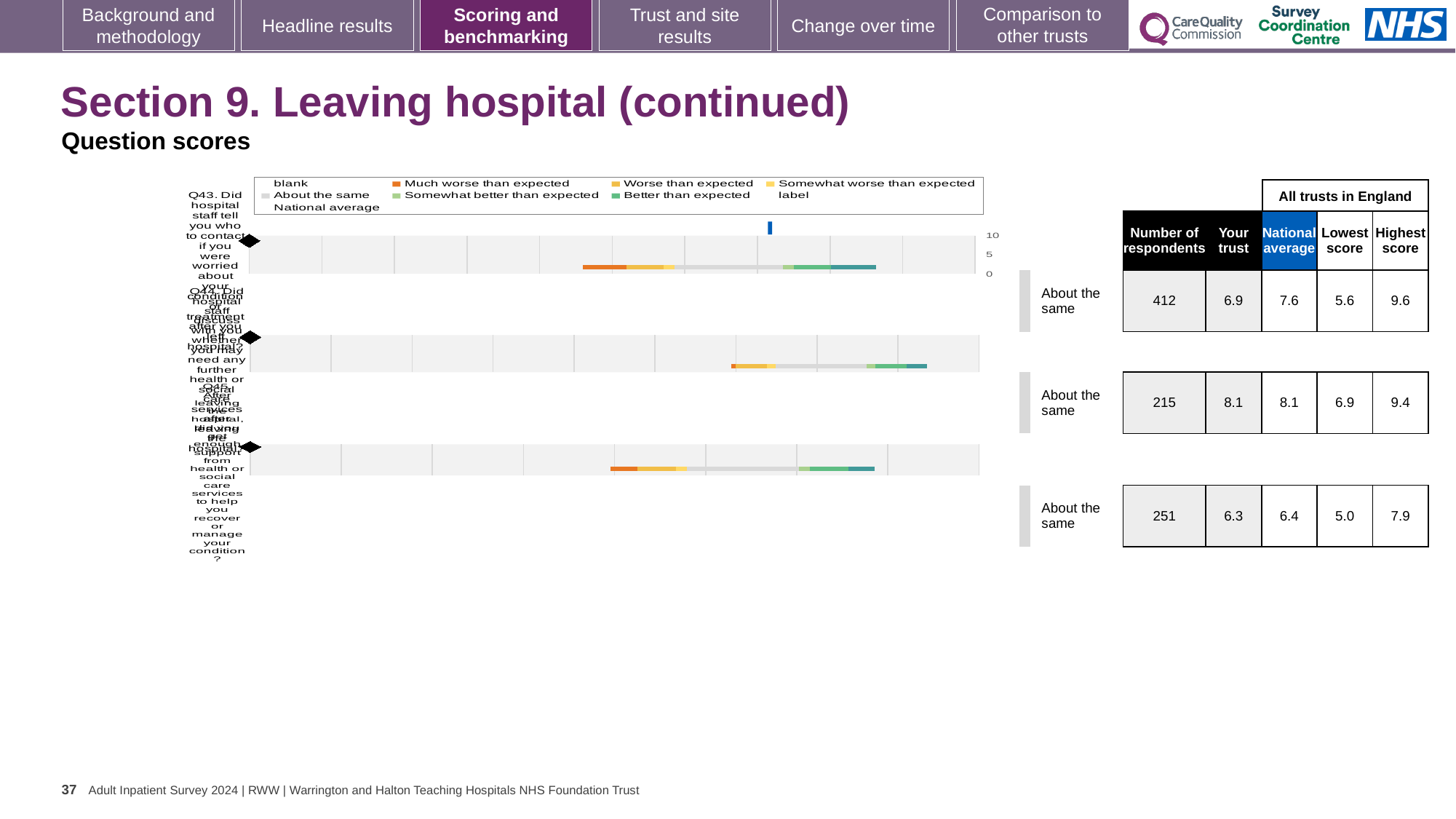
What is the highest value shown on the score axis of the charts? 10 In the table beside the charts, what is the number of respondents for the first question row (Q43)? 412 Which question row has the highest 'Your trust' score? the second row (8.1) For the first question row (Q43), which is larger: the 'Your trust' score or the national average? National average In the table beside the charts, what is the highest score for the third question row? 7.9 In the table beside the charts, what is the 'Your trust' score for the first question row (Q43)? 6.9 For the first question row (Q43), what is the difference between the national average and the 'Your trust' score? 0.7 How many question rows (charts) are shown on the slide? 3 Which question row has the fewest respondents? the second row (215) What kind of chart is used to show the question scores on this slide? bar chart In the legend, which colour represents 'Much worse than expected'? orange In the table beside the charts, what is the national average for the second question row? 8.1